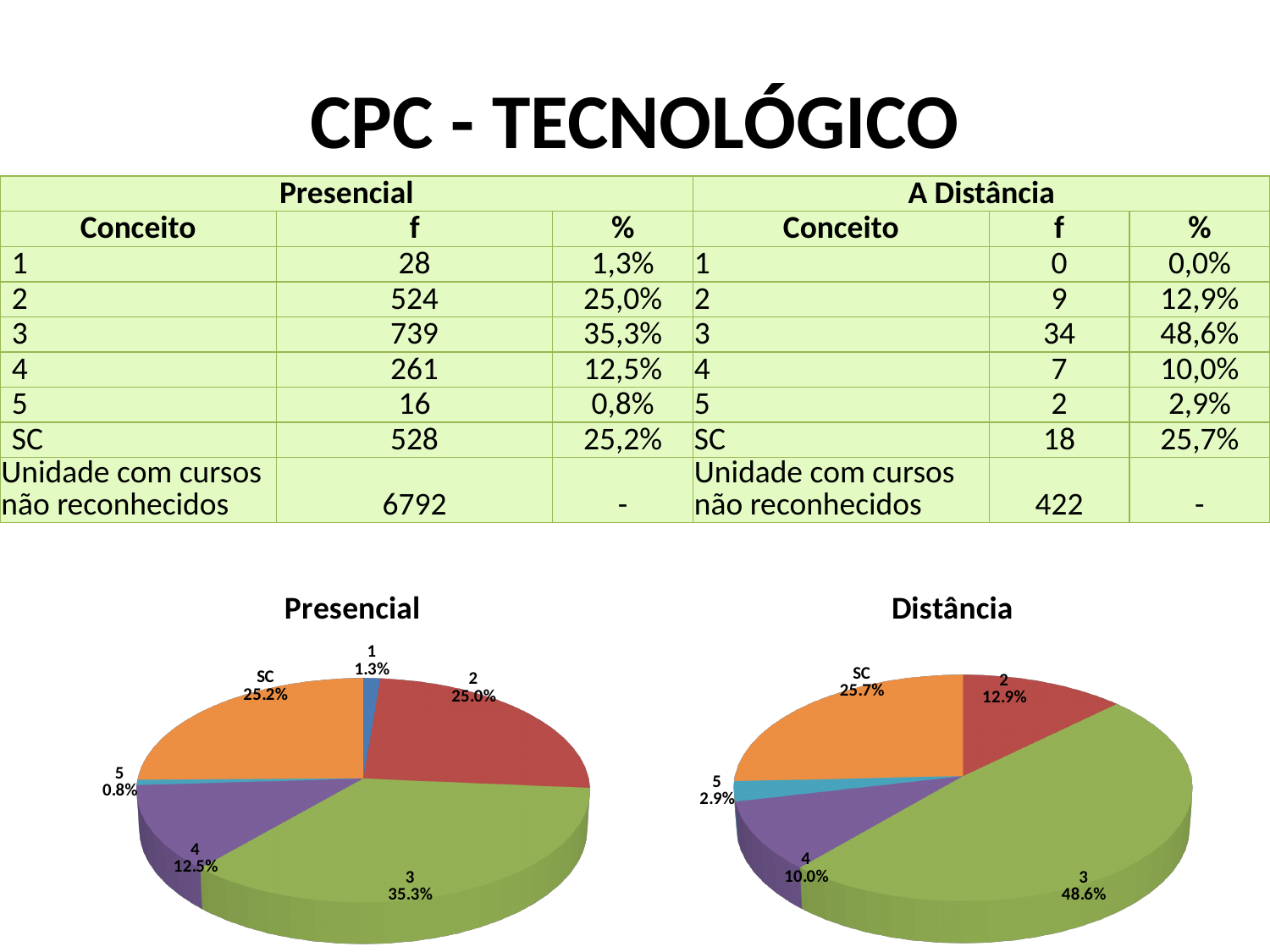
In the Presencial chart, what is the difference between the shares of slice 2 and slice 4? 12.5% In the Presencial chart, what share does the SC slice have? 25.2% What kind of chart is the Presencial chart? pie chart In the Presencial chart, which slice is the largest? 3 In the Presencial chart, which slice is the smallest? 5 In the Distância chart, which is larger, the SC slice or slice 2? SC In the Distância chart, which slice is the largest? 3 In the Presencial chart, how many slices are labelled? 6 In the Distância chart, how many slices are labelled? 5 In the Distância chart, what share does slice 4 have? 10.0% In the Presencial chart, what share does slice 3 have? 35.3%